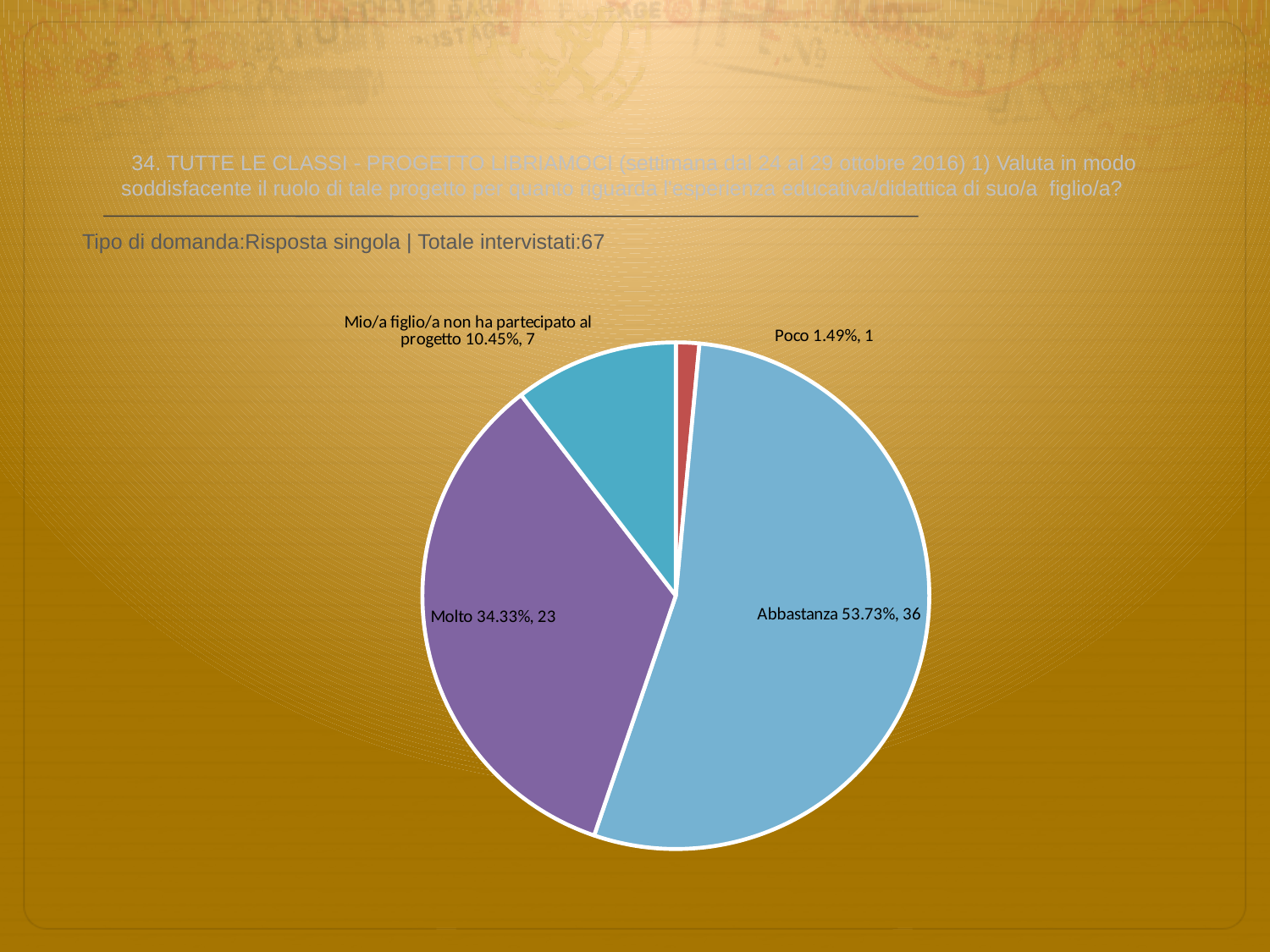
What is the difference in count between Abbastanza and Molto? 13 What colour is the Molto slice? purple How many slices does the pie chart have? 4 What kind of chart is shown on the slide? pie chart What is the total number of respondents (Totale intervistati) stated on the slide? 67 What percentage is shown for Poco? 1.49% Which is larger, the Molto slice or the 'Mio/a figlio/a non ha partecipato al progetto' slice? Molto Which category has the smallest slice? Poco What is the count shown for Molto? 23 What is the count shown for the slice 'Mio/a figlio/a non ha partecipato al progetto'? 7 Which category has the largest slice? Abbastanza What percentage share does the Abbastanza slice have? 53.73%